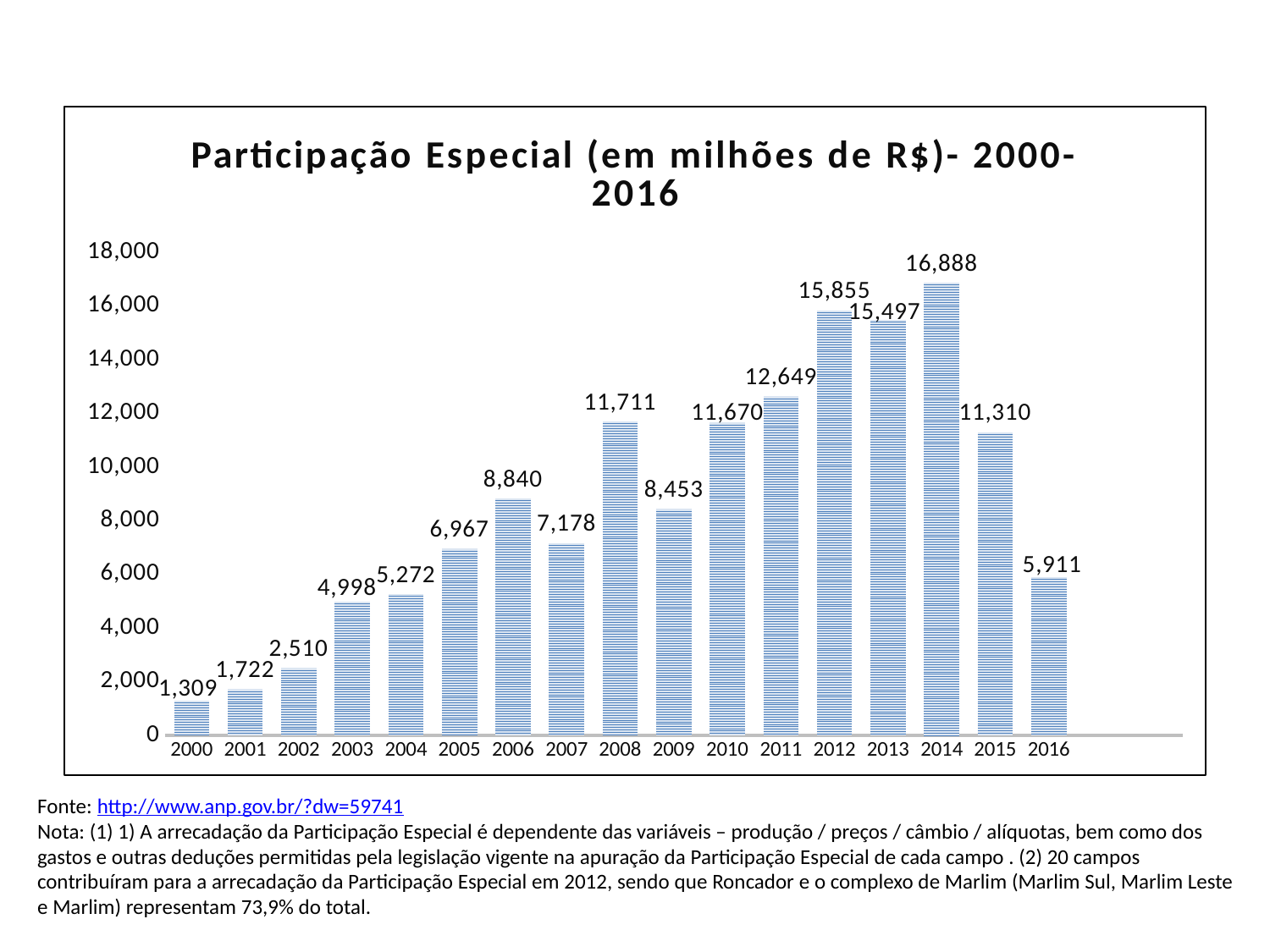
Which year has the highest value? 2014 Which is larger, the value for 2009 or the value for 2010? 2010 What kind of chart is this? bar chart What is the value for 2016? 5,911 Which year has the lowest value? 2000 What is the difference between the values for 2014 and 2015? 5,578 What is the title of the chart? Participação Especial (em milhões de R$)- 2000-2016 What is the value for 2000? 1,309 Do the values rise or fall from 2000 to 2006? rise Is the value for 2012 greater or less than 14,000? greater What is the value for 2008? 11,711 How many years are shown on the x axis? 17